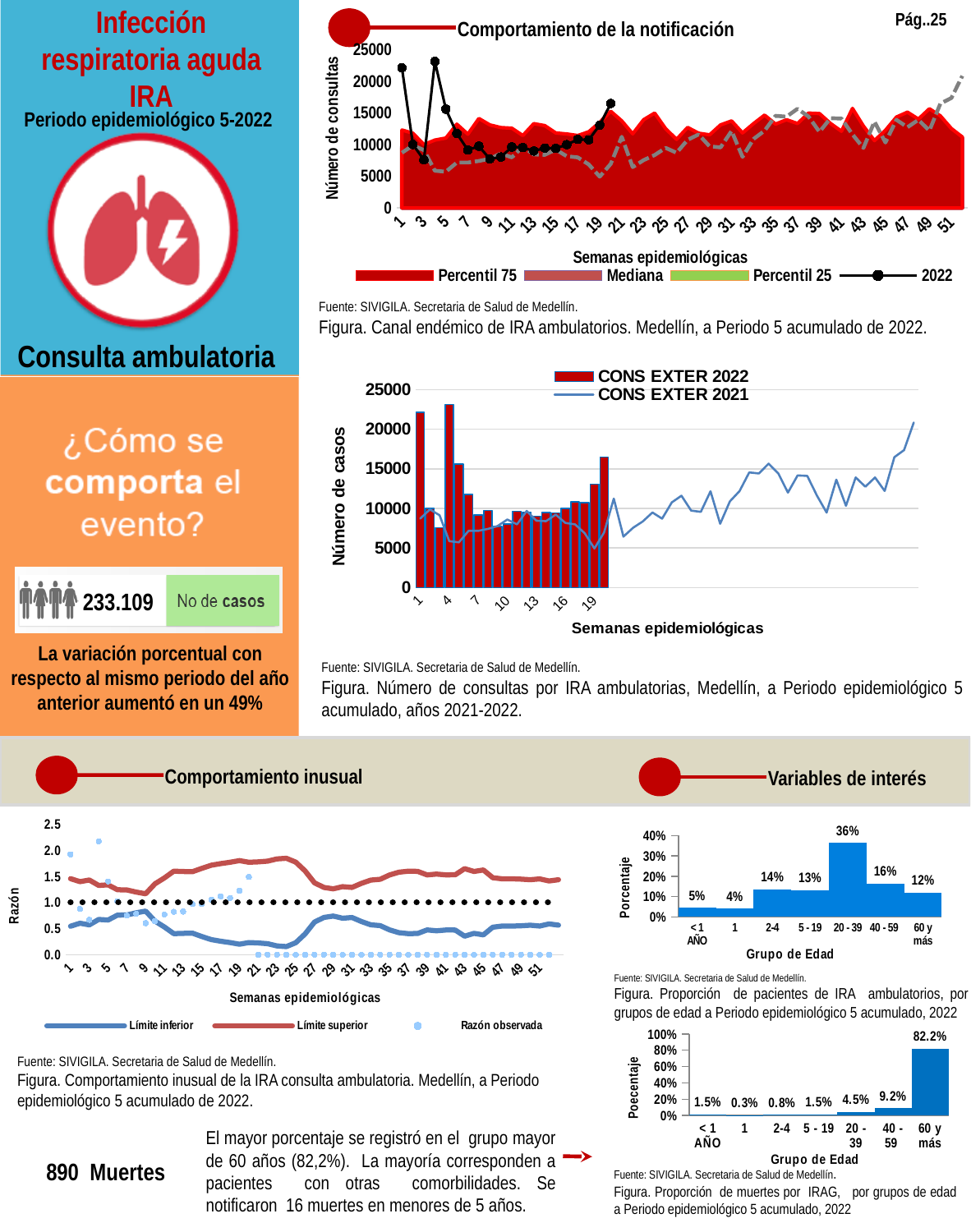
In the chart of proportion of deaths by IRAG by age group, what type of chart is used? Bar chart In the chart of proportion of deaths by IRAG by age group, which age group has the lowest percentage? 1 In the chart of proportion of IRA ambulatory patients by age group, how many age groups are shown? 7 In the 'Comportamiento de la notificación' chart at the top right, how many series does the legend list? 4 In the chart of proportion of deaths by IRAG by age group, what is the difference between the 40 - 59 group and the 20 - 39 group? 4.7% In the chart of proportion of IRA ambulatory patients by age group (Figura. Proporción de pacientes de IRA ambulatorios), what is the value for the 20 - 39 age group? 36% In the chart of number of IRA ambulatory consultations 2021-2022 (CONS EXTER), how many series does the legend list? 2 In the chart of proportion of deaths by IRAG by age group (Figura. Proporción de muertes por IRAG), what is the value for the 60 y más group? 82.2% In the chart of proportion of deaths by IRAG by age group, which is larger: the value for 20 - 39 or the value for 40 - 59? 40 - 59 In the 'Comportamiento inusual' chart at the bottom left, what are the three legend entries? Límite inferior, Límite superior, Razón observada In the chart of proportion of IRA ambulatory patients by age group, which age group has the lowest percentage? 1 In the chart of proportion of IRA ambulatory patients by age group, what is the difference between the 40 - 59 group and the 60 y más group? 4%